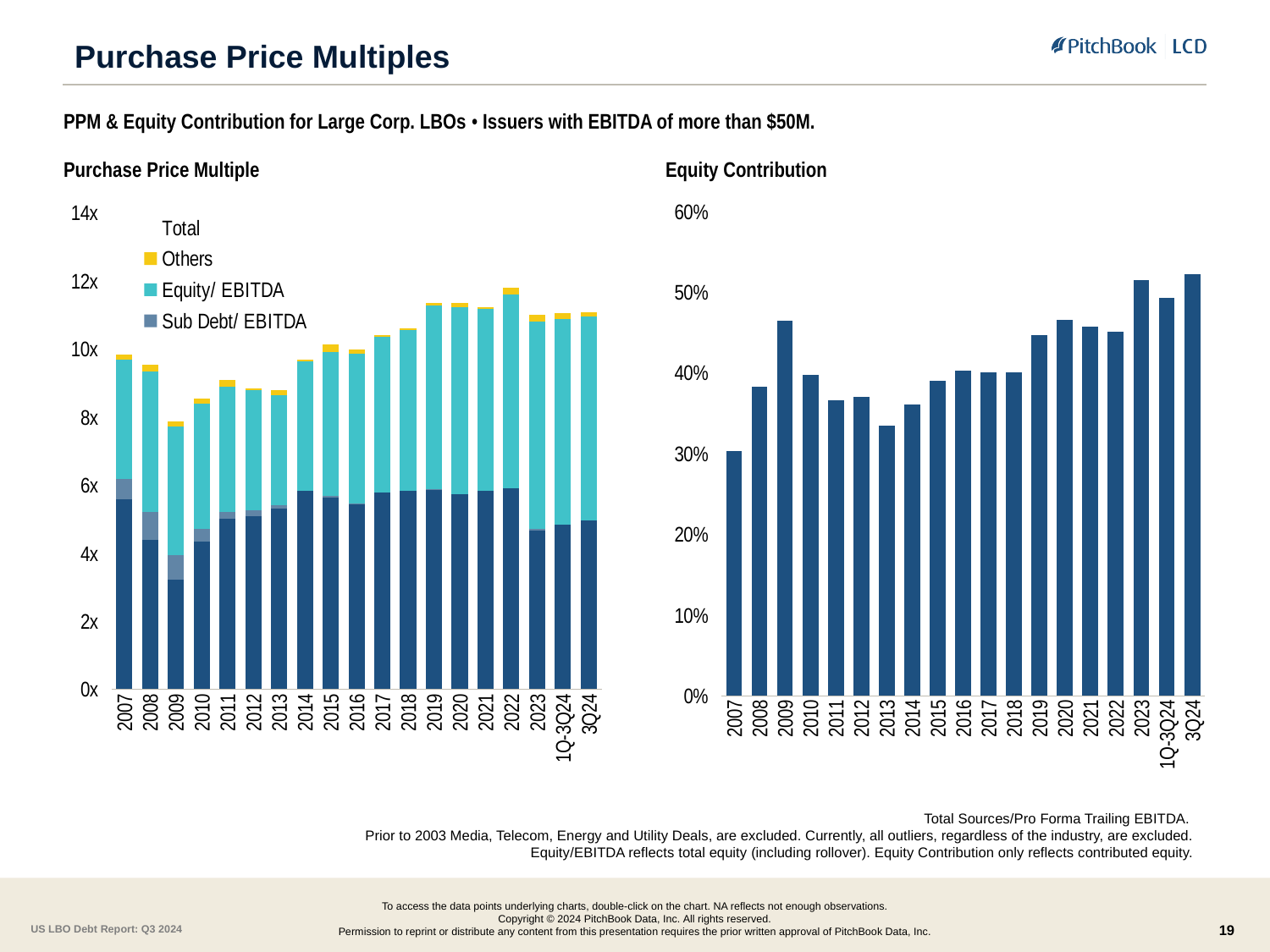
In the Purchase Price Multiple chart, which year has the lowest total purchase price multiple? 2009 In the Purchase Price Multiple chart, which year has the highest total purchase price multiple? 2022 How many periods are shown on the x axis of the Equity Contribution chart? 19 In the Equity Contribution chart, which is larger, the value for 2009 or the value for 2010? 2009 In the Equity Contribution chart, which year has the lowest equity contribution? 2007 What kind of chart is the Purchase Price Multiple chart? Stacked bar chart How many legend entries does the Purchase Price Multiple chart list? 4 In the Purchase Price Multiple chart, is the Sub Debt/ EBITDA value for 2009 greater or less than 4x? less In the Equity Contribution chart, is the value for 2013 greater or less than 40%? less What kind of chart is the Equity Contribution chart? Bar chart In the Purchase Price Multiple chart, is the total for 2022 greater or less than 10x? greater